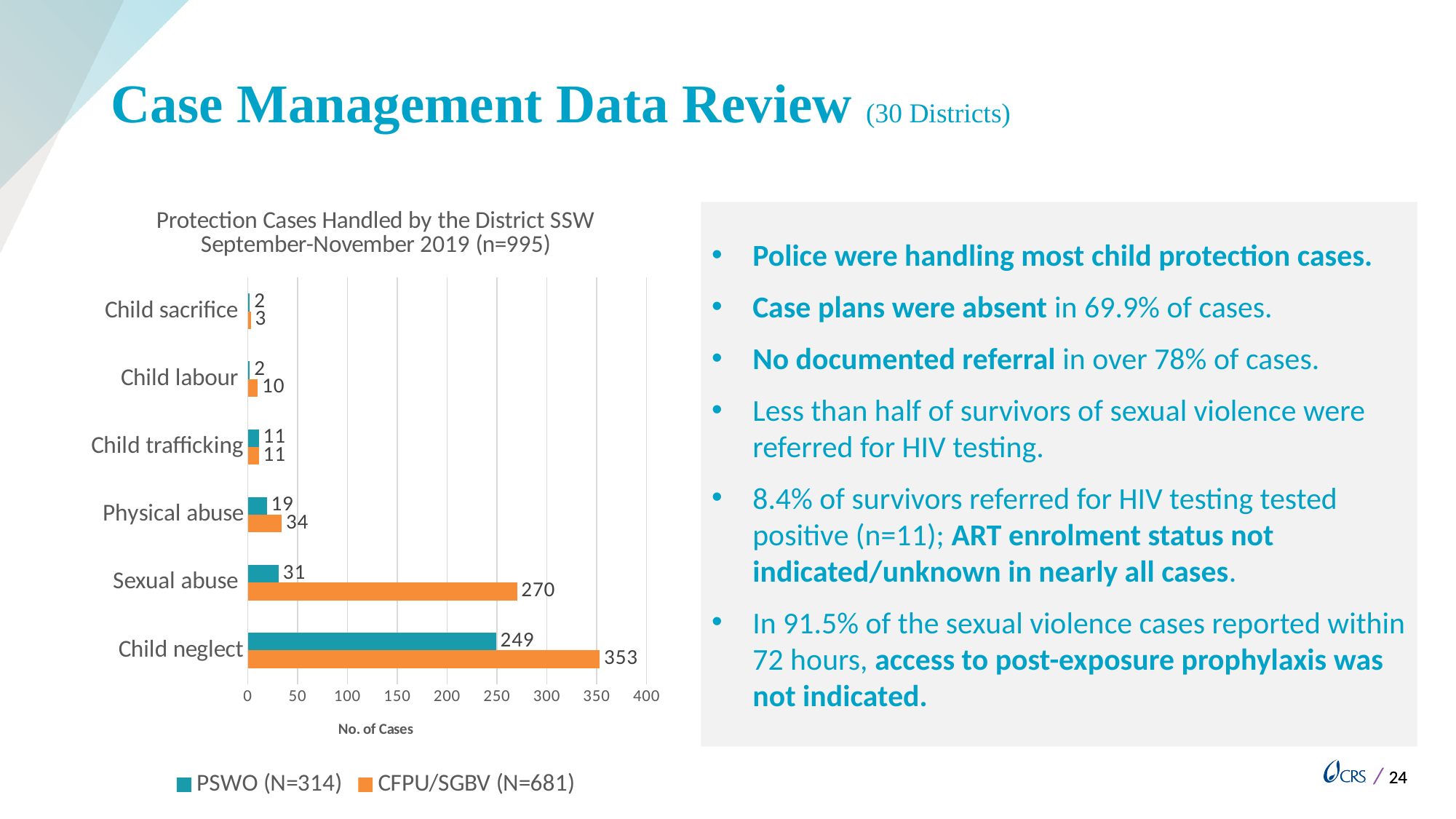
What is the label of the x axis of the chart? No. of Cases Which category has the highest PSWO (N=314) value? Child neglect What is the CFPU/SGBV (N=681) value for Physical abuse? 34 Is the CFPU/SGBV (N=681) value for Sexual abuse greater or less than 250? greater What is the PSWO (N=314) value for Sexual abuse? 31 How many categories are shown on the chart? 6 Which is larger for Child neglect: the PSWO (N=314) value or the CFPU/SGBV (N=681) value? CFPU/SGBV (N=681) Which category has the lowest CFPU/SGBV (N=681) value? Child sacrifice What is the difference between the CFPU/SGBV (N=681) and PSWO (N=314) values for Sexual abuse? 239 How many series does the legend list? 2 What kind of chart is shown on the slide? Bar chart What is the CFPU/SGBV (N=681) value for Child neglect? 353